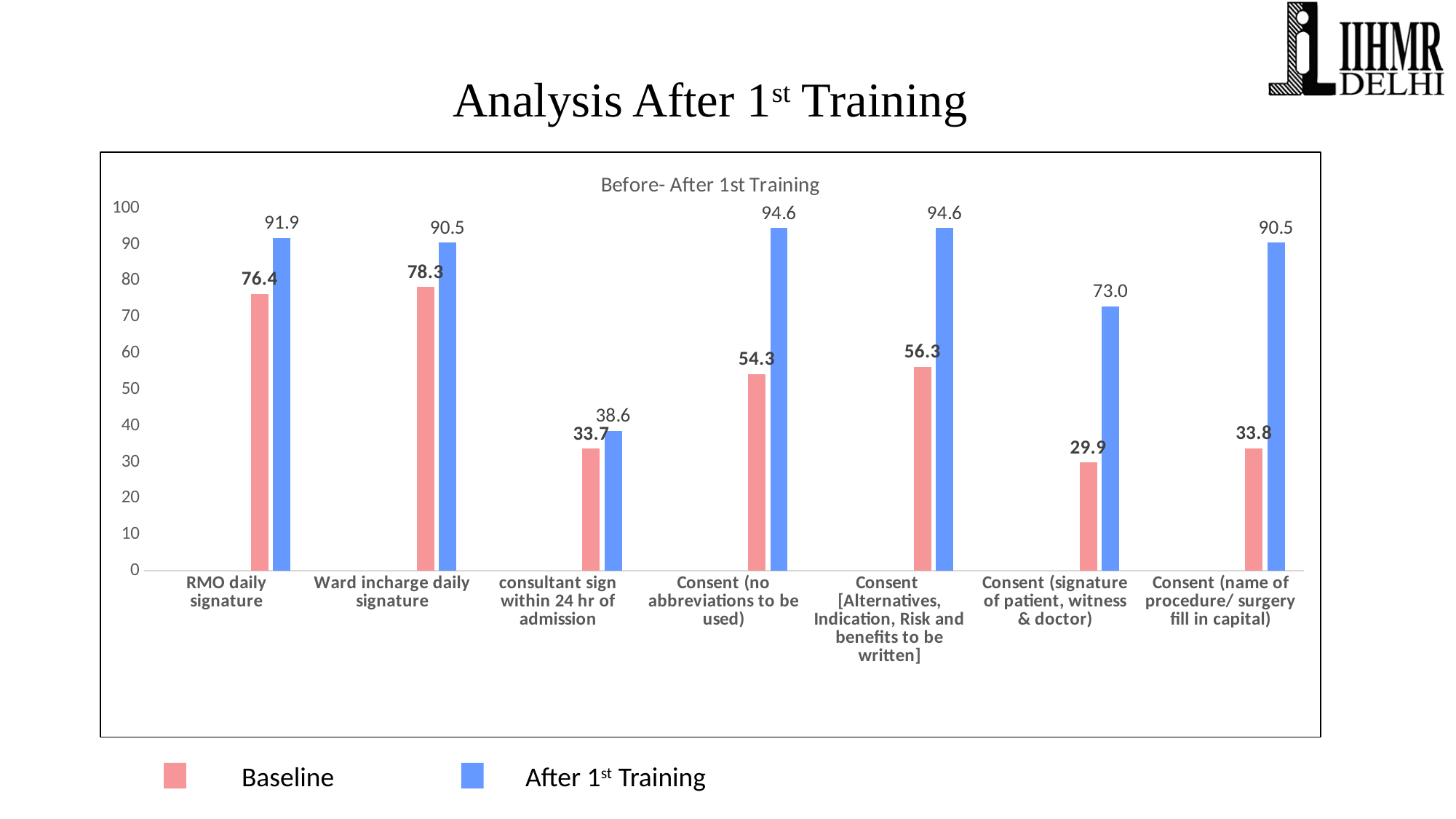
Which category has the lowest After 1st Training value? consultant sign within 24 hr of admission Which category has the highest Baseline value? Ward incharge daily signature What kind of chart is shown on the slide? Bar chart Is the Baseline value for Consent (no abbreviations to be used) larger than the Baseline value for Consent [Alternatives, Indication, Risk and benefits to be written]? No How many series does the legend list? 2 What is the Baseline value for consultant sign within 24 hr of admission? 33.7 What is the Baseline value for RMO daily signature? 76.4 How many categories are shown on the x axis? 7 What is the After 1st Training value for Consent (signature of patient, witness & doctor)? 73.0 What is the difference between the After 1st Training and Baseline values for Consent (name of procedure/ surgery fill in capital)? 56.7 Which category has the lowest Baseline value? Consent (signature of patient, witness & doctor) What is the title of the chart? Before- After 1st Training